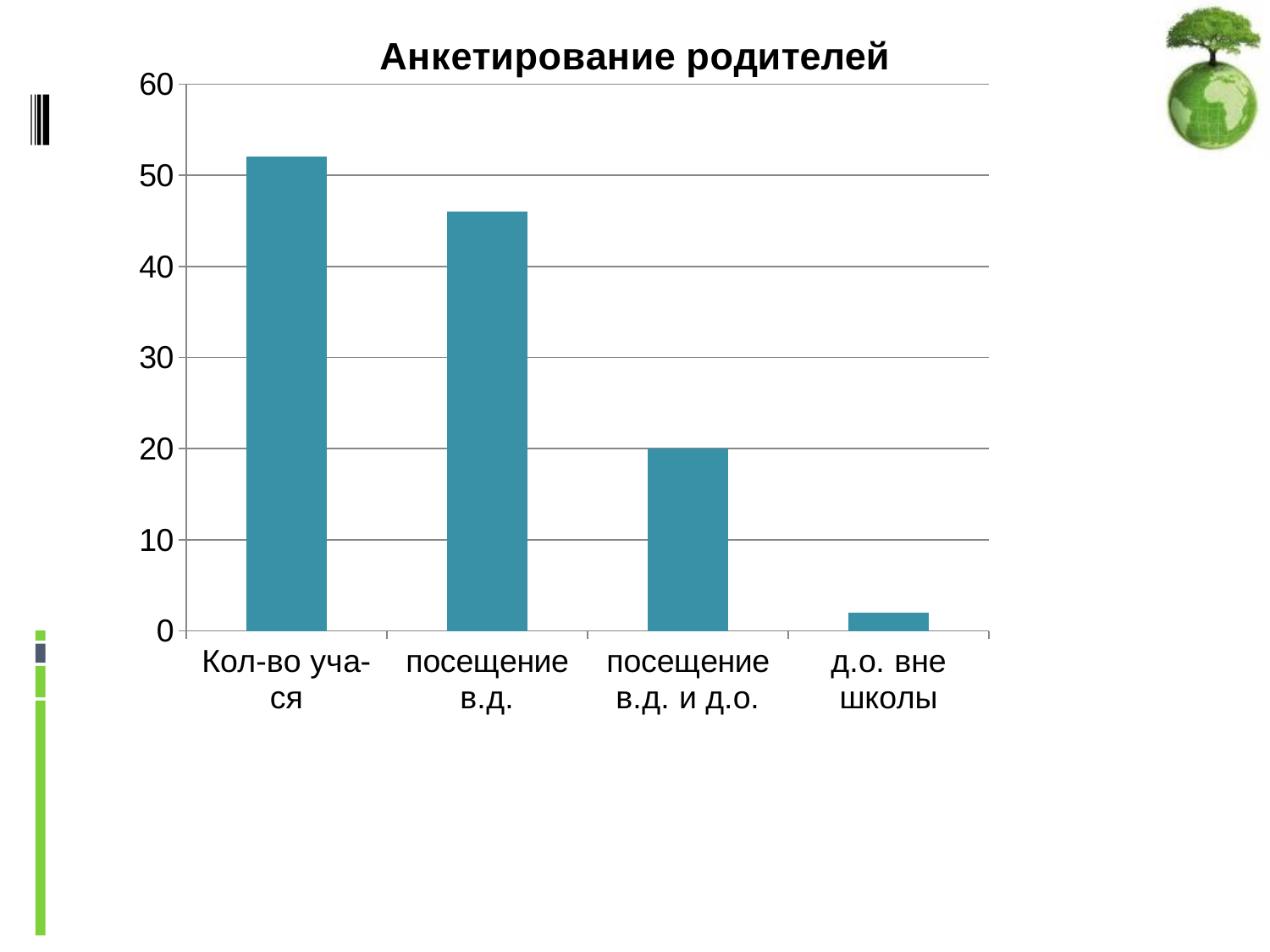
Is the value for Кол-во уча-ся greater or less than 50? greater What is the value for посещение в.д. и д.о.? 20 Do the values rise or fall from left to right along the x axis? fall Which category has the highest value? Кол-во уча-ся How many categories are shown on the x axis of the chart? 4 Is the value for посещение в.д. greater or less than 40? greater Which category has the lowest value? д.о. вне школы Is the value for д.о. вне школы greater or less than 10? less Which is larger, the value for Кол-во уча-ся or the value for посещение в.д.? Кол-во уча-ся What kind of chart is shown on the slide? bar chart What is the title of the chart? Анкетирование родителей